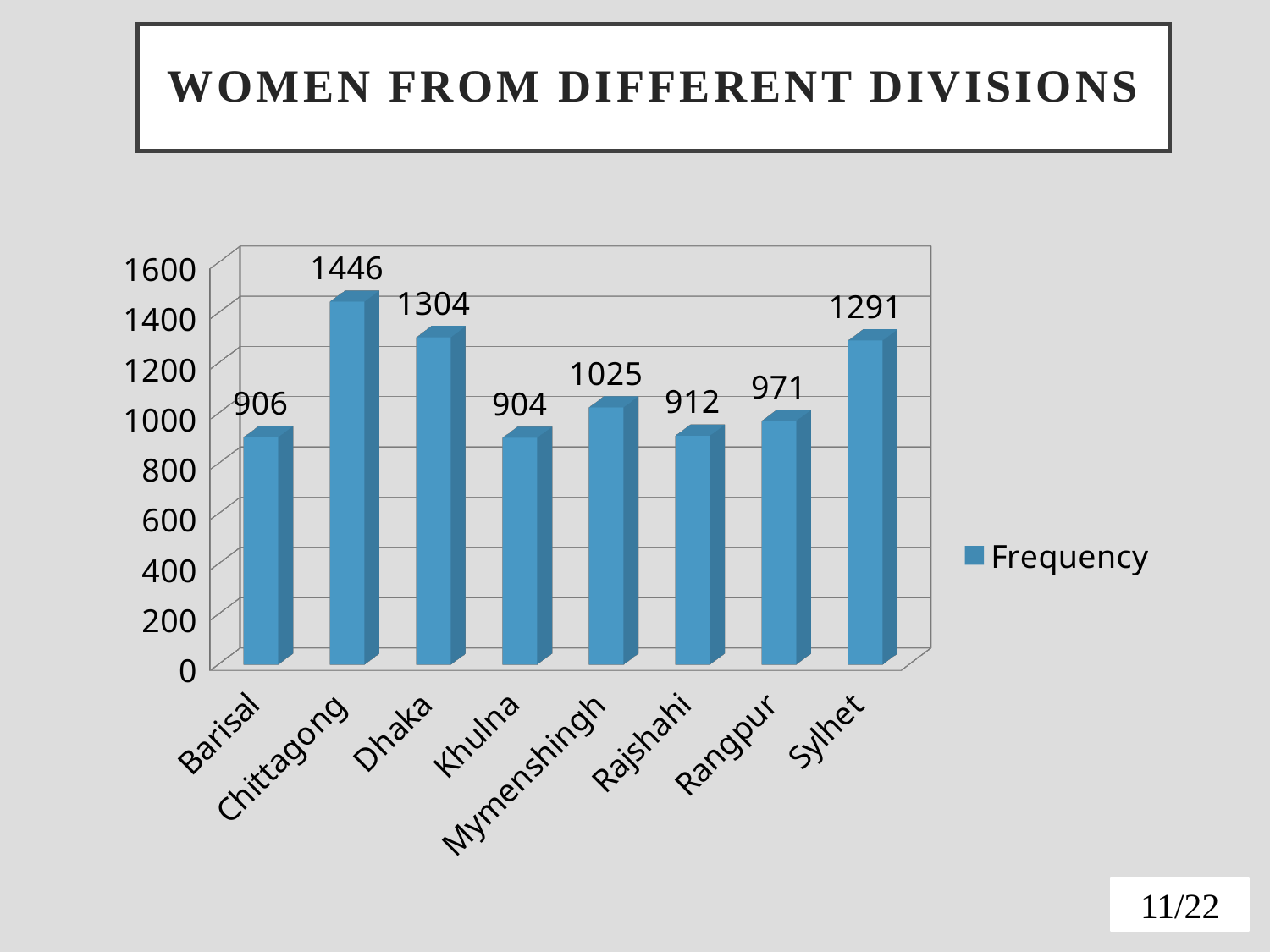
Which has a higher frequency, Rangpur or Rajshahi? Rangpur What is the frequency for Sylhet? 1291 What is the difference between the frequencies for Chittagong and Dhaka? 142 What is the frequency for Chittagong? 1446 What is the title of the chart? WOMEN FROM DIFFERENT DIVISIONS How many series does the legend list? 1 Which division has the highest frequency? Chittagong How many divisions are shown on the x axis? 8 Is the value for Barisal greater or less than 1000? less What kind of chart is shown on the slide? Bar chart Which division has the lowest frequency? Khulna What is the frequency for Mymenshingh? 1025